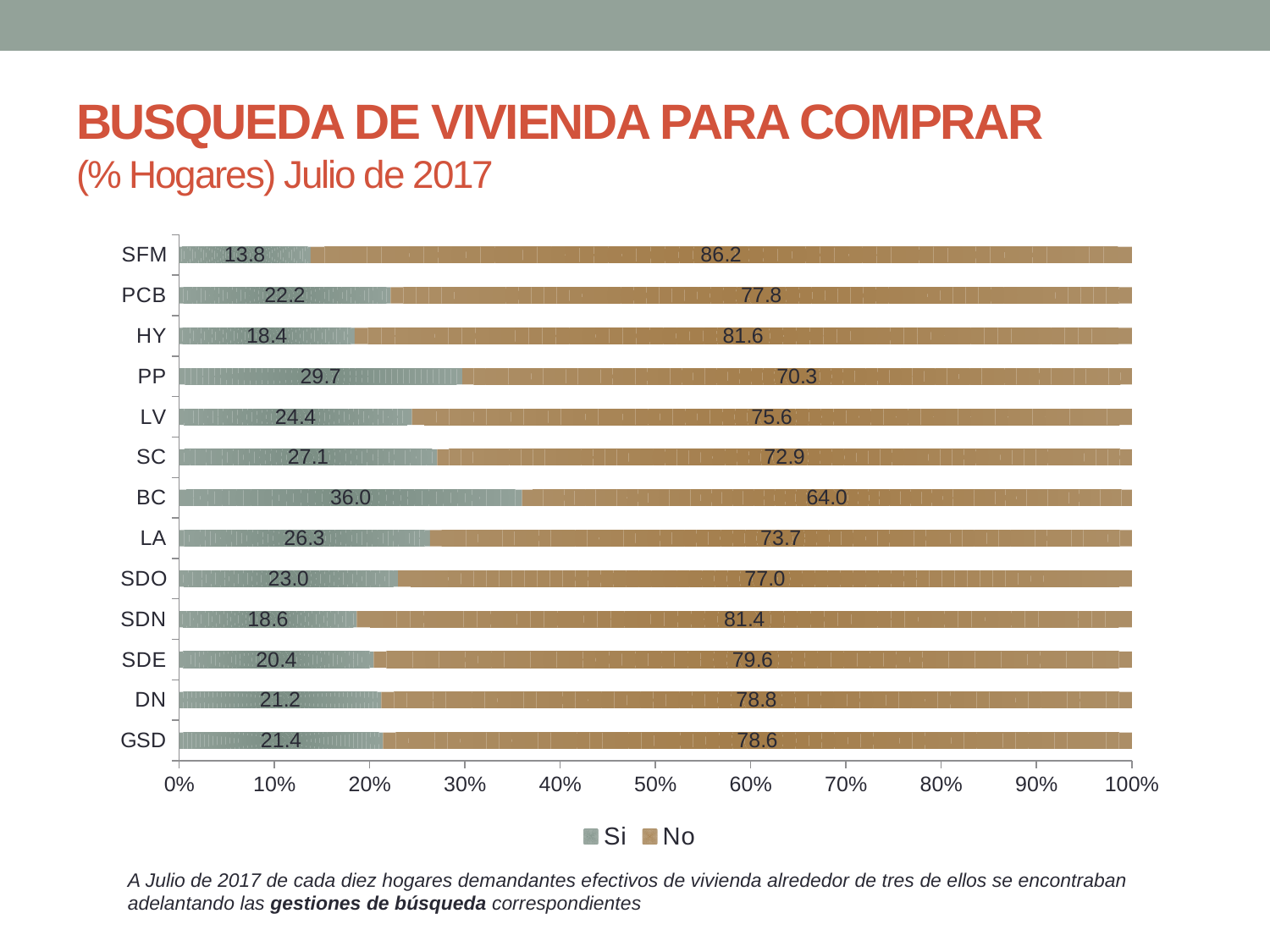
What are the two legend entries of the chart? Si and No How many series does the legend list? 2 What is the 'Si' value for PP? 29.7 What is the 'No' value for SFM? 86.2 Which has a larger 'Si' value, LV or HY? LV What is the difference between the 'No' value and the 'Si' value for SC? 45.8 What is the total of the stacked bar for SDO? 100.0 Which category has the lowest 'Si' value? SFM Which category has the highest 'Si' value? BC What kind of chart is shown on the slide? Stacked bar chart How many categories are shown on the y axis? 13 What is the 'Si' value for BC? 36.0